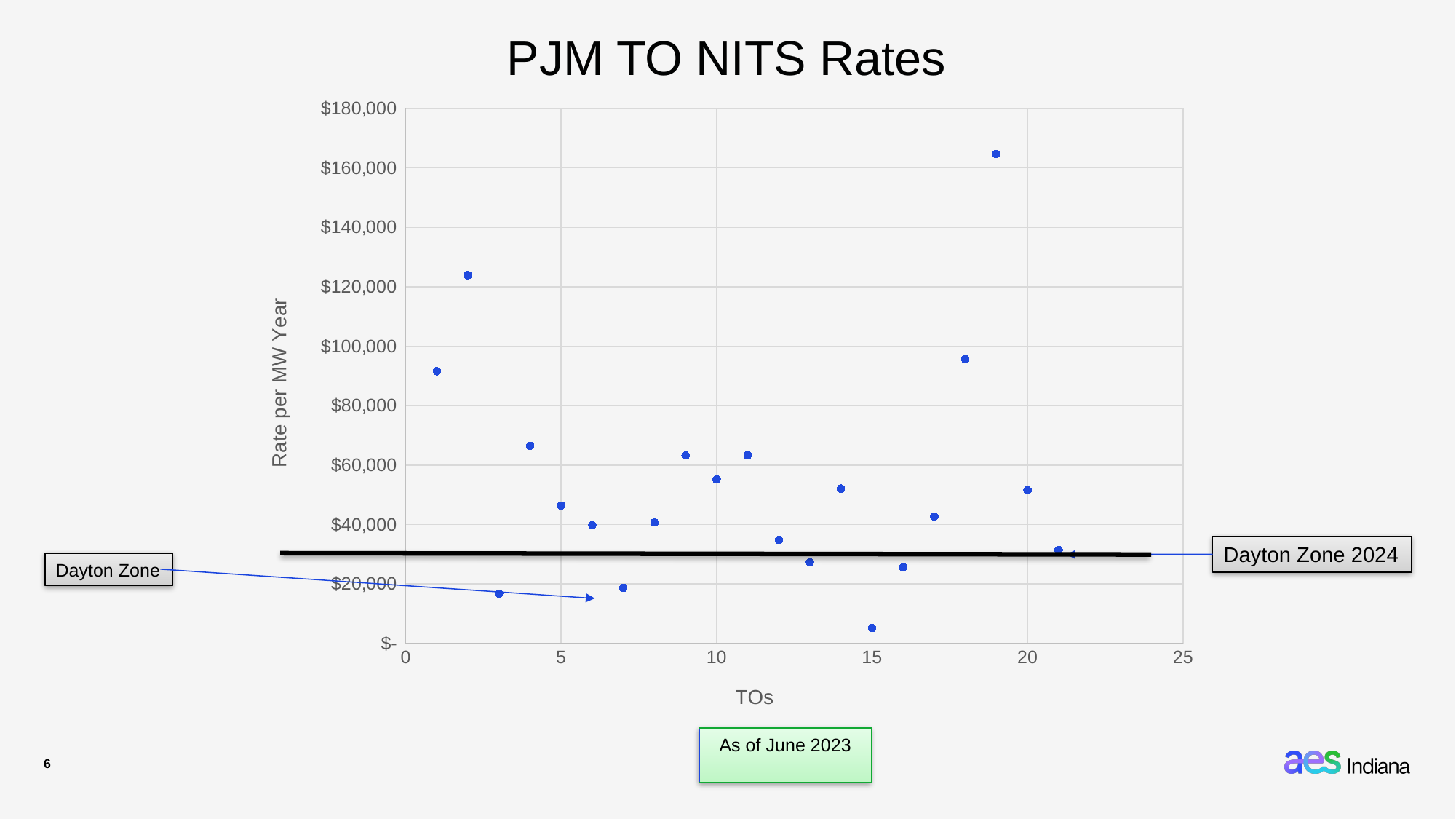
What type of chart is shown on the slide? scatter chart Which has a higher rate per MW year, TO 3 or TO 14? TO 14 Is the rate for TO 18 greater or less than $100,000? less What is the label of the vertical axis? Rate per MW Year What is the title of the chart? PJM TO NITS Rates Is the rate for TO 2 greater or less than $120,000? greater Which TO number has the highest rate per MW year? 19 Is the rate for TO 19 greater or less than $160,000? greater How many data points are plotted in the chart? 21 Which has a higher rate per MW year, TO 1 or TO 4? TO 1 Which TO number has the lowest rate per MW year? 15